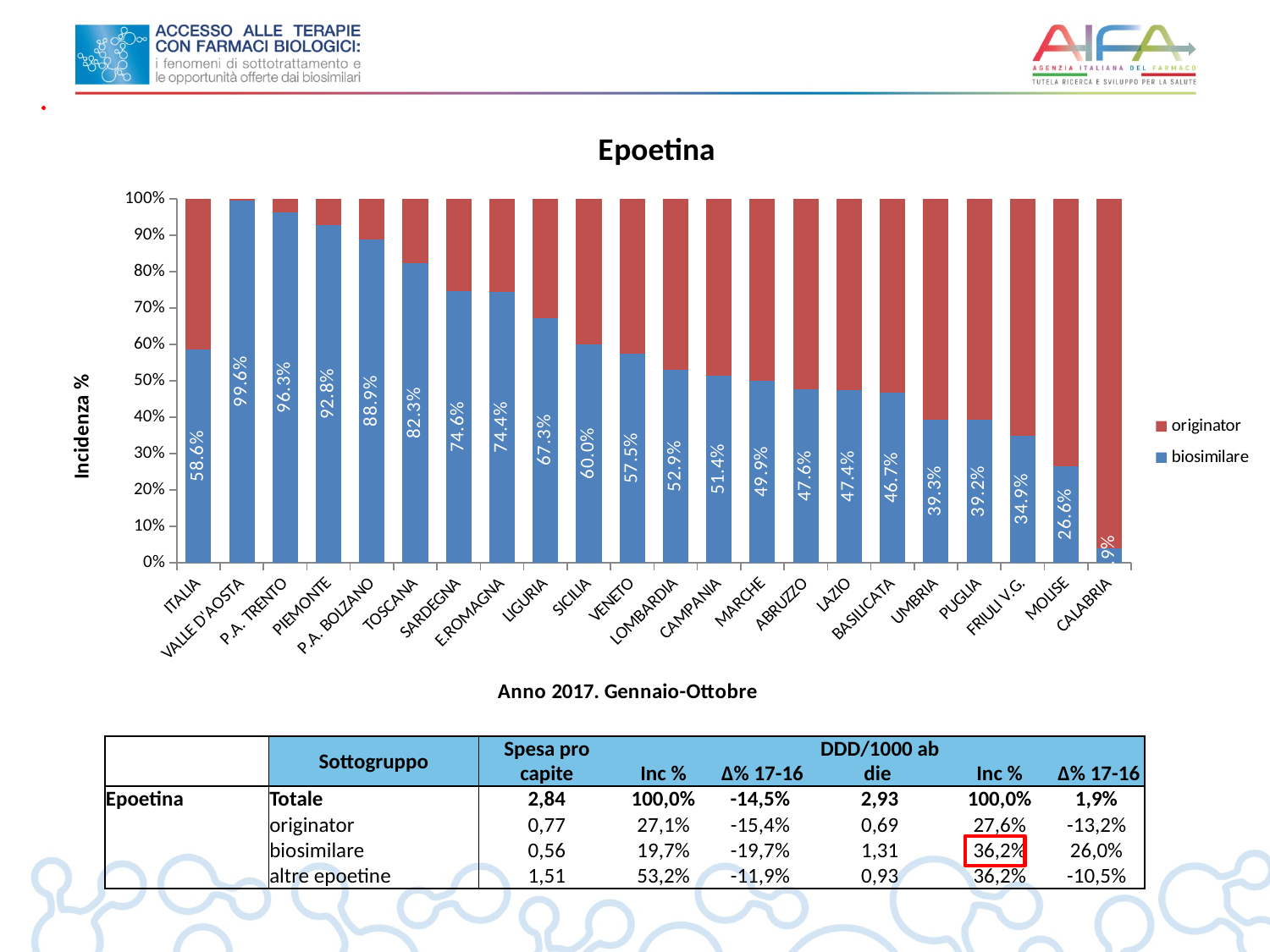
What is the biosimilare share for ITALIA in the Epoetina chart? 58.6% What is the difference in biosimilare share between ITALIA and VENETO? 1.1 percentage points Which region has the lowest biosimilare share? CALABRIA Which has a larger biosimilare share, SARDEGNA or LIGURIA? SARDEGNA What is the biosimilare share for TOSCANA? 82.3% What kind of chart is shown on the slide? Stacked bar chart How many regions/categories are shown on the x axis of the chart? 22 Which region has the highest biosimilare share? VALLE D'AOSTA Is the originator share for CALABRIA greater or less than 90%? greater How many series does the legend list? 2 What is the biosimilare share for FRIULI V.G.? 34.9% Excluding ITALIA, do the biosimilare shares rise or fall from left to right along the x axis? Fall